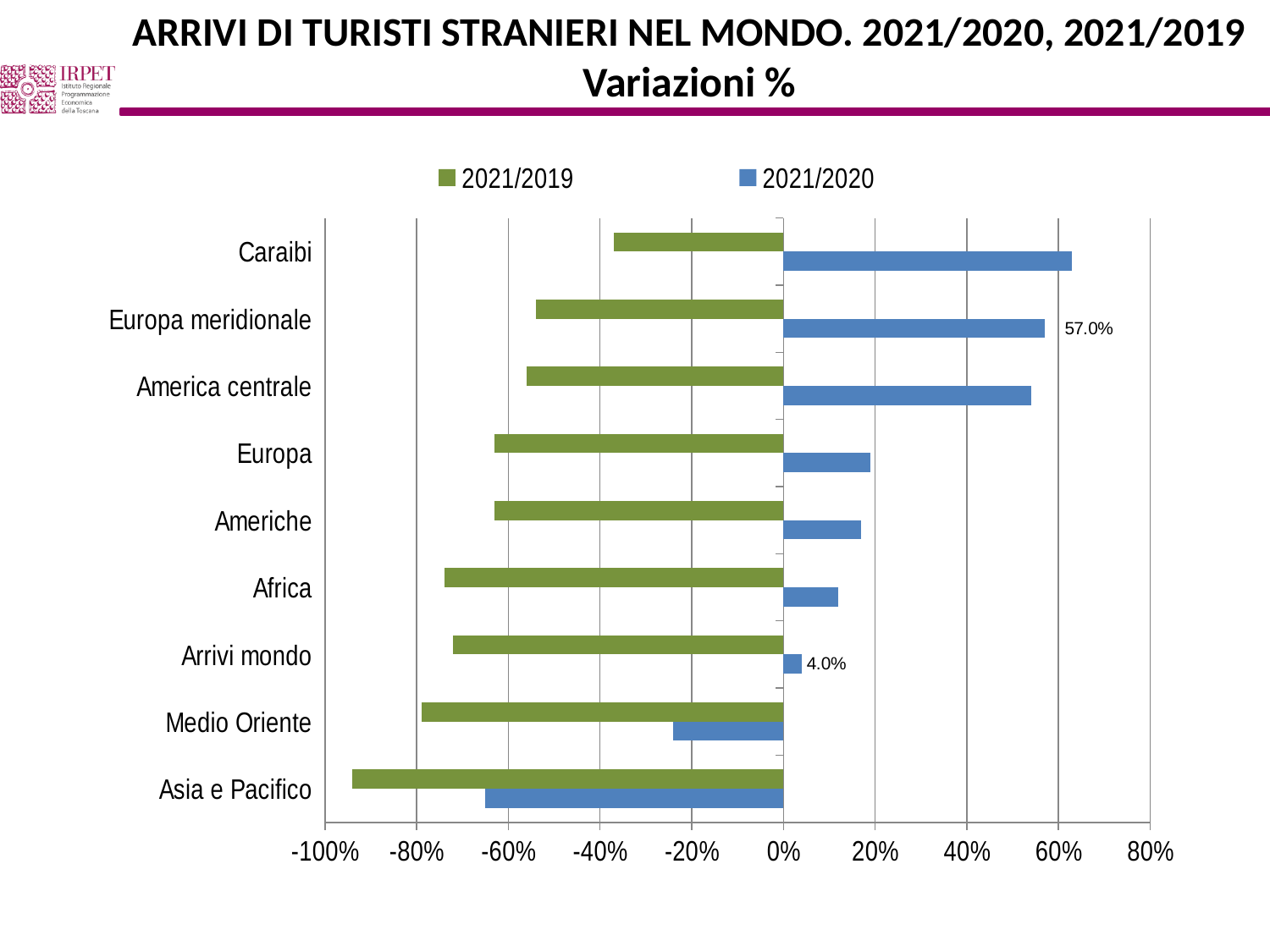
Which region has the lowest 2021/2020 value? Asia e Pacifico Is the 2021/2020 value for Africa greater or less than 20%? less How many series does the legend list? 2 Which series is shown in green in the legend? 2021/2019 What is the 2021/2020 value for Arrivi mondo? 4.0% For the 2021/2020 series, which is larger: Caraibi or Europa? Caraibi What is the 2021/2020 value for Europa meridionale? 57.0% Which region has the lowest 2021/2019 value? Asia e Pacifico How many regions (categories) are shown on the chart? 9 Is the 2021/2019 value for Asia e Pacifico greater or less than -80%? less Which region has the highest 2021/2020 value? Caraibi What type of chart is shown on the slide? bar chart